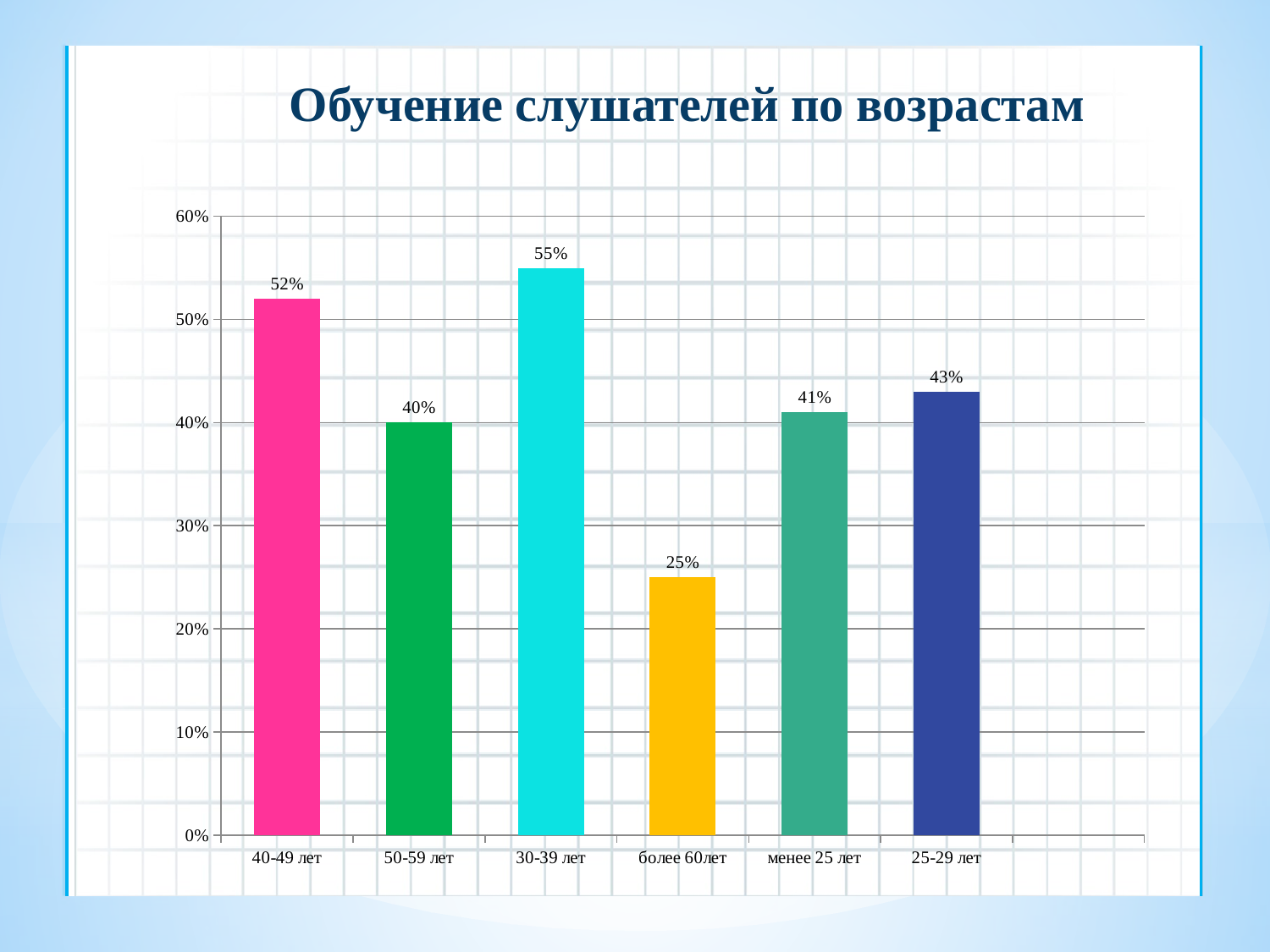
Which category has the lowest value? более 60лет Which category has the highest value? 30-39 лет How many categories are shown on the chart? 6 What kind of chart is shown on the slide? bar chart Is the value for 40-49 лет greater or less than 50%? greater Which is larger, the value for 25-29 лет or the value for 50-59 лет? 25-29 лет What is the value for 40-49 лет? 52% What is the value for менее 25 лет? 41% What is the difference between the values for 30-39 лет and 50-59 лет? 15% What is the title of the chart? Обучение слушателей по возрастам What colour is the bar for более 60лет? yellow What is the value for более 60лет? 25%